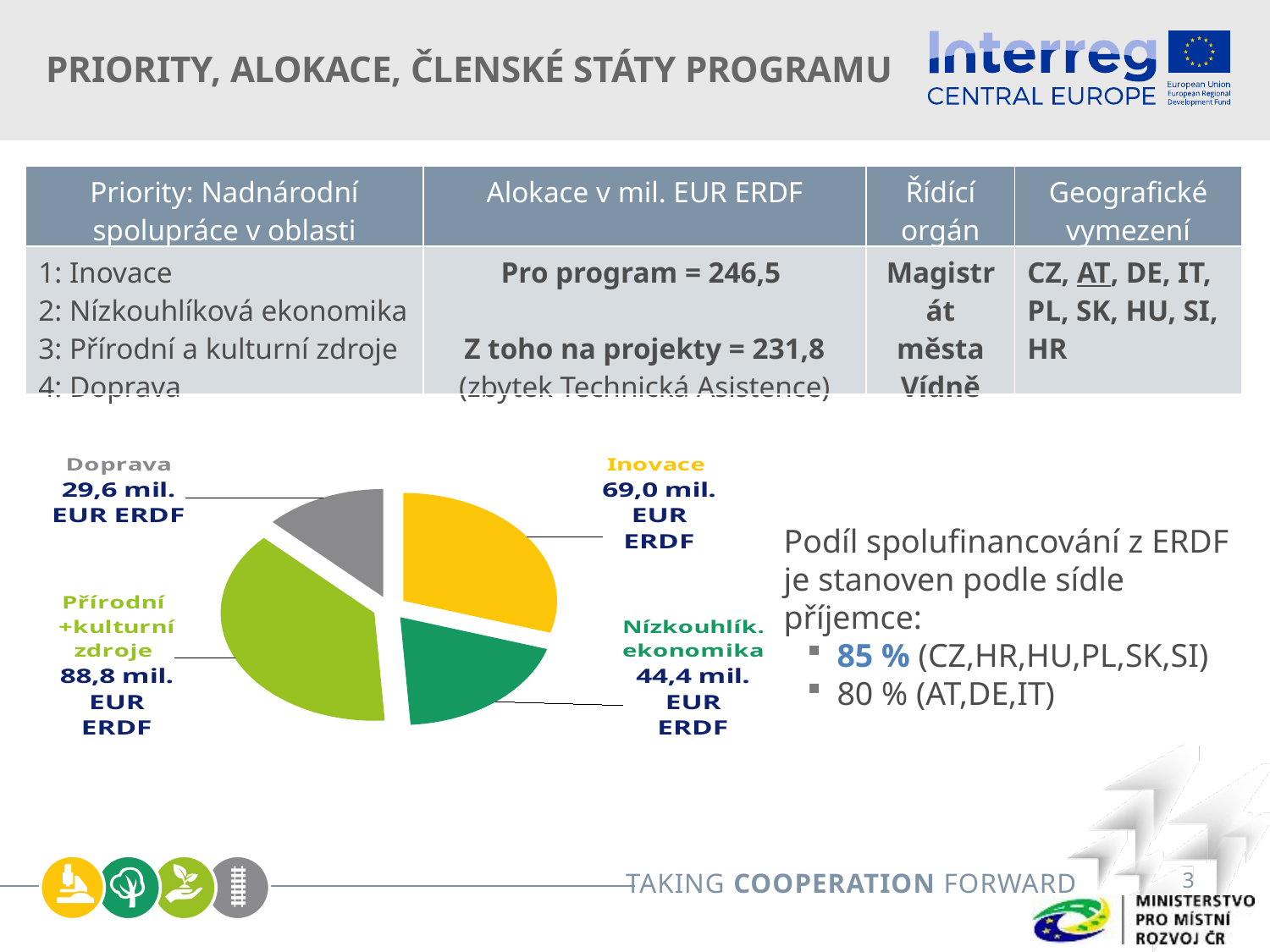
What is the difference between the Přírodní +kulturní zdroje value and the Inovace value in the pie chart? 19,8 mil. EUR ERDF What is the value shown for the Inovace slice of the pie chart? 69,0 mil. EUR ERDF What is the value shown for the Doprava slice of the pie chart? 29,6 mil. EUR ERDF What is the value shown for the Nízkouhlík. ekonomika slice of the pie chart? 44,4 mil. EUR ERDF What colour is the Inovace slice of the pie chart? Yellow How many slices does the pie chart have? 4 What is the difference between the Nízkouhlík. ekonomika value and the Doprava value in the pie chart? 14,8 mil. EUR ERDF Which is larger in the pie chart, Inovace or Nízkouhlík. ekonomika? Inovace What kind of chart is shown on the slide? Pie chart Which slice of the pie chart has the largest value? Přírodní +kulturní zdroje Which slice of the pie chart has the smallest value? Doprava What is the value shown for the Přírodní +kulturní zdroje slice of the pie chart? 88,8 mil. EUR ERDF